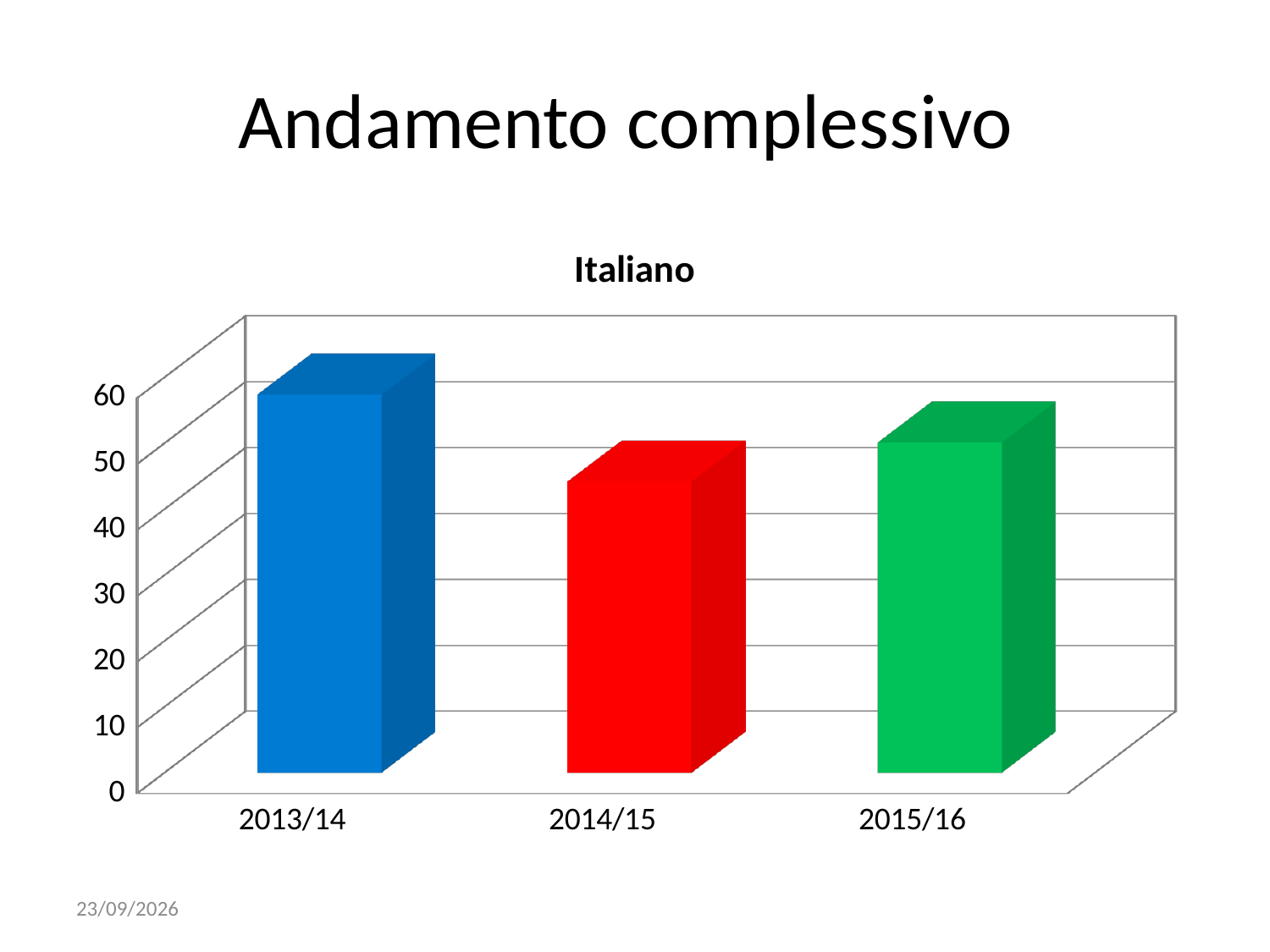
What kind of chart is shown on the slide? bar chart Is the value for 2015/16 greater or less than 40? greater What colour is the bar for 2014/15? red Which is larger, the value for 2014/15 or the value for 2015/16? 2015/16 What is the title of the chart? Italiano Does the value rise or fall from 2013/14 to 2014/15? fall Which category has the lowest value in the chart? 2014/15 Is the value for 2013/14 greater or less than 50? greater How many categories are shown on the x axis of the chart? 3 Which category has the highest value in the chart? 2013/14 Is the value for 2014/15 greater or less than 50? less Which is larger, the value for 2013/14 or the value for 2015/16? 2013/14